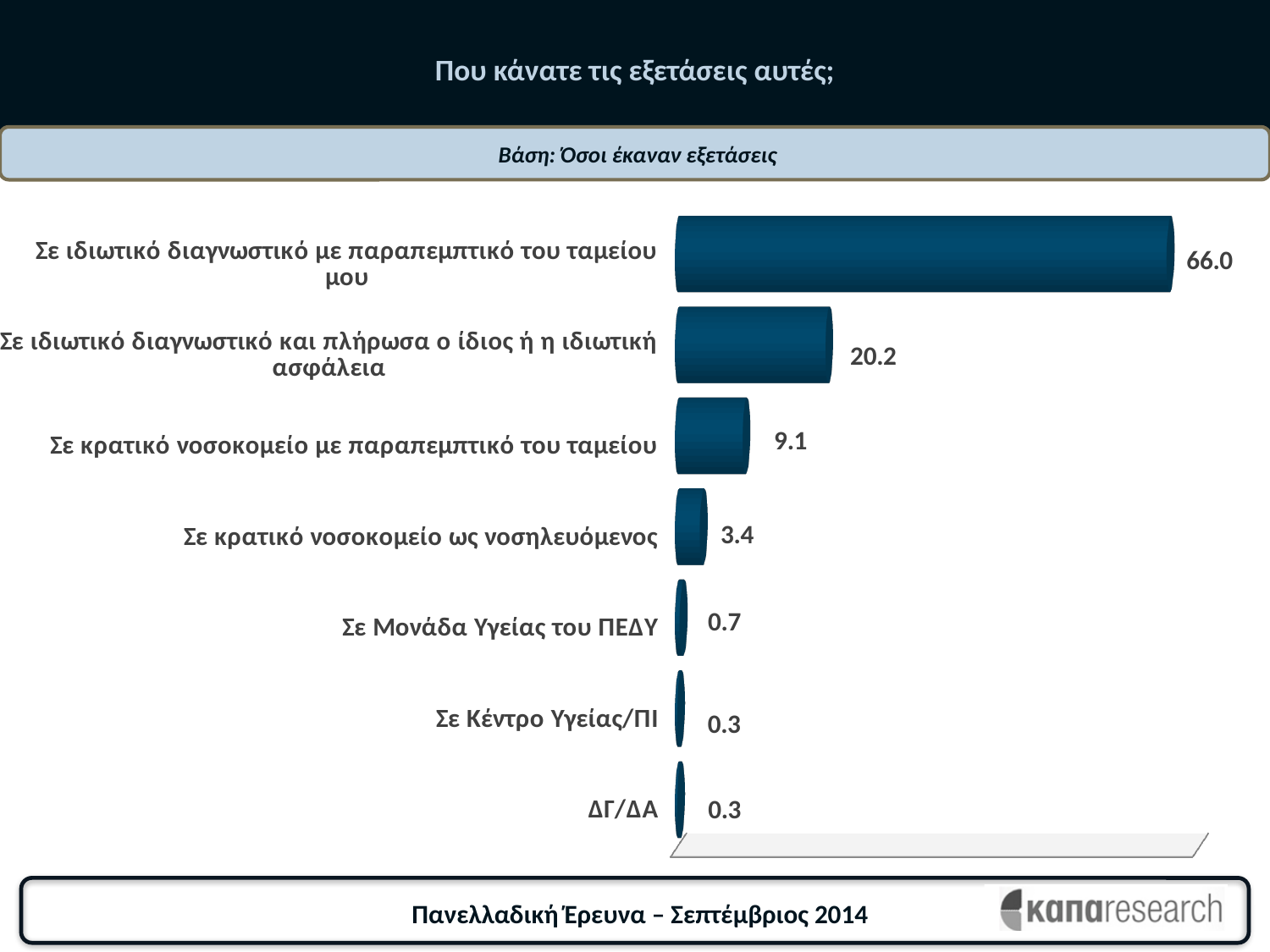
What is the title of the slide? Που κάνατε τις εξετάσεις αυτές; Which is larger: the value for 'Σε ιδιωτικό διαγνωστικό και πλήρωσα ο ίδιος ή η ιδιωτική ασφάλεια' or 'Σε κρατικό νοσοκομείο με παραπεμπτικό του ταμείου'? Σε ιδιωτικό διαγνωστικό και πλήρωσα ο ίδιος ή η ιδιωτική ασφάλεια What is the difference between the values for 'Σε κρατικό νοσοκομείο με παραπεμπτικό του ταμείου' and 'Σε κρατικό νοσοκομείο ως νοσηλευόμενος'? 5.7 What base is stated for the chart? Όσοι έκαναν εξετάσεις What is the value for 'Σε ιδιωτικό διαγνωστικό με παραπεμπτικό του ταμείου μου'? 66.0 What is the value for 'Σε κρατικό νοσοκομείο με παραπεμπτικό του ταμείου'? 9.1 What is the difference between the values for 'Σε ιδιωτικό διαγνωστικό με παραπεμπτικό του ταμείου μου' and 'Σε ιδιωτικό διαγνωστικό και πλήρωσα ο ίδιος ή η ιδιωτική ασφάλεια'? 45.8 What is the value for 'Σε Μονάδα Υγείας του ΠΕΔΥ'? 0.7 How many categories are shown in the chart? 7 What kind of chart is shown on the slide? Bar chart What is the value for 'ΔΓ/ΔΑ'? 0.3 Which category has the highest value? Σε ιδιωτικό διαγνωστικό με παραπεμπτικό του ταμείου μου